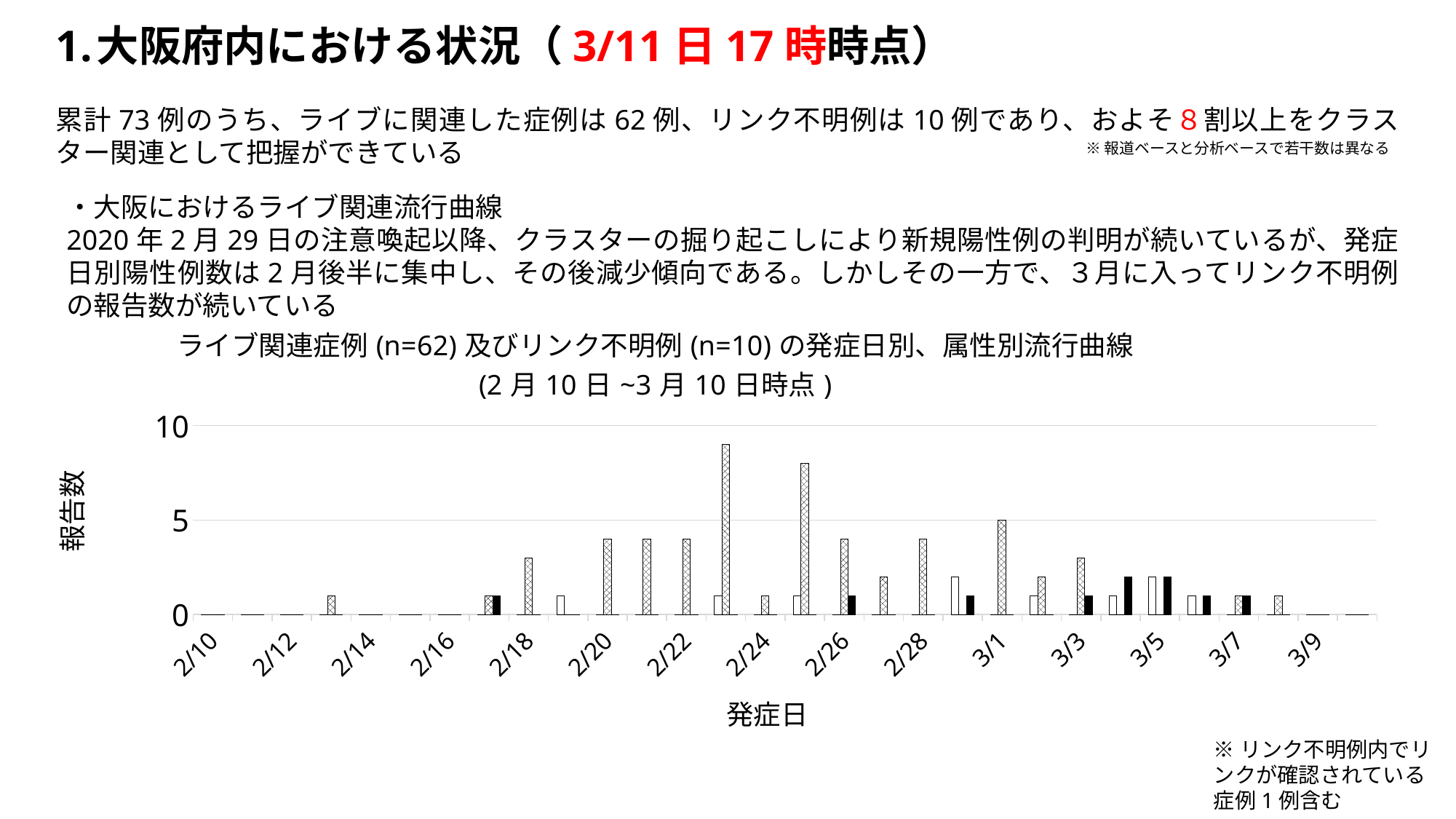
Is the hatched bar for 2/18 greater or less than 5? less Do the hatched bars generally rise or fall from 2/26 to 3/9? fall What kind of chart is shown on the slide? bar chart How many date labels are shown on the x axis? 15 What is the label of the x axis of the chart? 発症日 What is the title of the chart? ライブ関連症例(n=62)及びリンク不明例(n=10)の発症日別、属性別流行曲線 (2月10日~3月10日時点) Is the hatched bar for 2/20 greater or less than 5? less Is the hatched bar for 2/28 greater or less than 5? less Which is larger, the hatched bar for 2/22 or the hatched bar for 3/9? 2/22 Which is larger, the hatched bar for 2/20 or the hatched bar for 2/14? 2/20